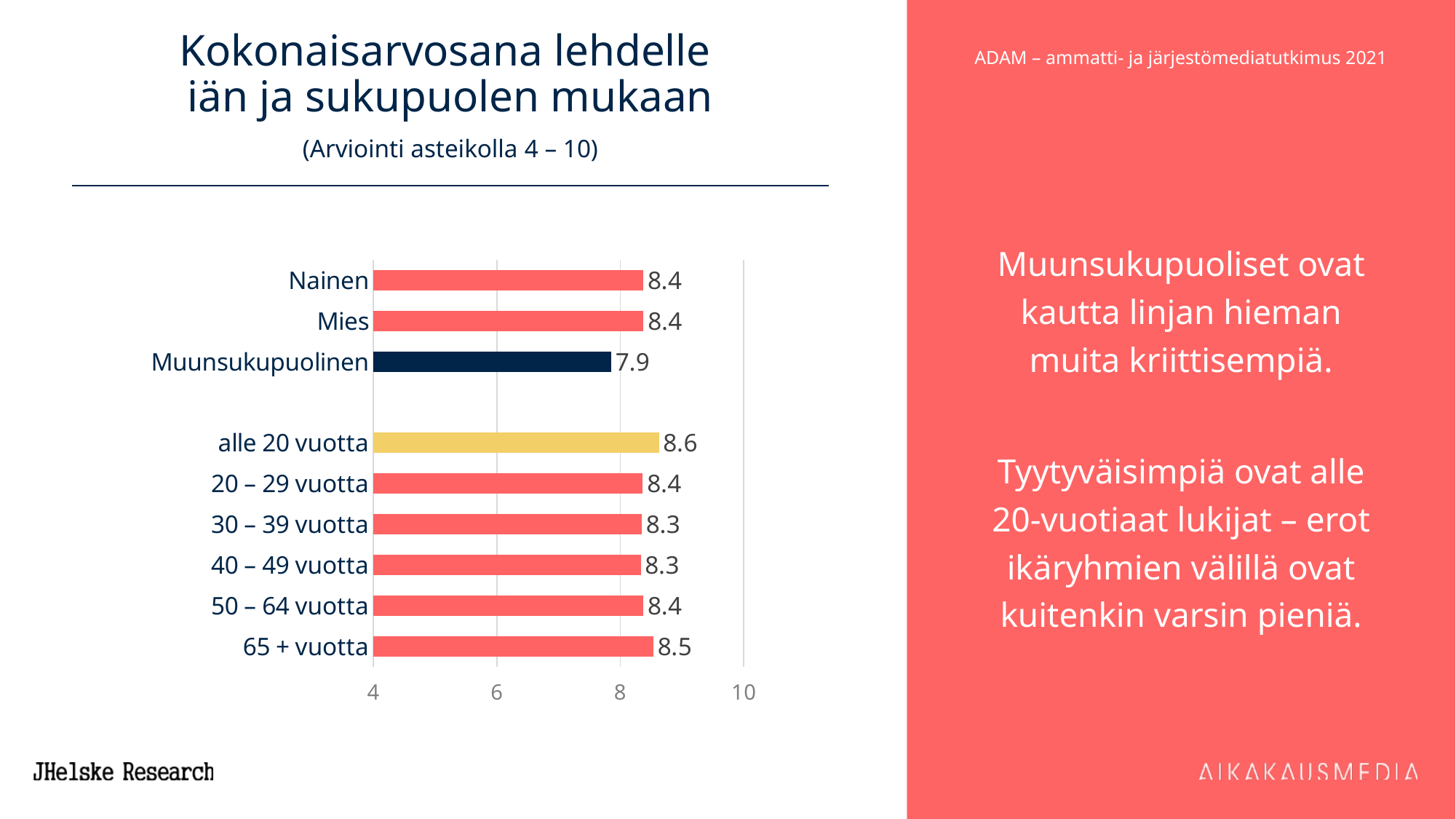
Which is larger, the value for 65 + vuotta or the value for 40 – 49 vuotta? 65 + vuotta What is the title of the chart? Kokonaisarvosana lehdelle iän ja sukupuolen mukaan How many categories are shown in the chart? 9 What is the value for 65 + vuotta? 8.5 What is the value for Muunsukupuolinen? 7.9 What kind of chart is shown on the slide? bar chart What is the value for alle 20 vuotta? 8.6 Which category has the lowest value? Muunsukupuolinen Which category has the highest value? alle 20 vuotta Is the value for Muunsukupuolinen greater or less than 8? less What is the difference between the values for alle 20 vuotta and Muunsukupuolinen? 0.7 What is the value for 30 – 39 vuotta? 8.3